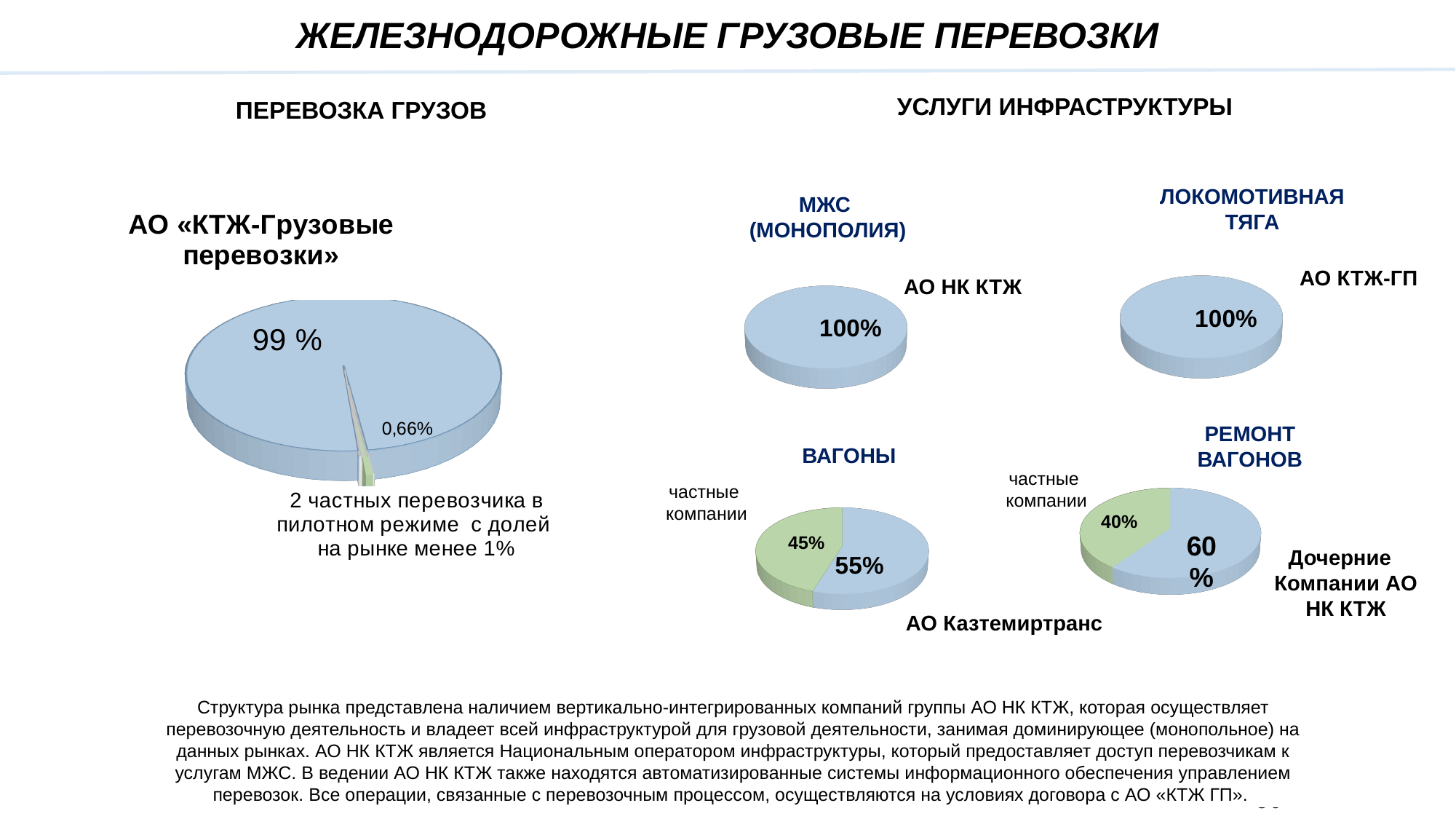
On the ВАГОНЫ pie chart, which slice is larger: АО Казтемиртранс or частные компании? АО Казтемиртранс On the ЛОКОМОТИВНАЯ ТЯГА pie chart, what share is labelled for АО КТЖ-ГП? 100% On the ПЕРЕВОЗКА ГРУЗОВ pie chart, what share is labelled for АО «КТЖ-Грузовые перевозки»? 99 % On the РЕМОНТ ВАГОНОВ pie chart, what share is labelled for Дочерние Компании АО НК КТЖ? 60% On the ВАГОНЫ pie chart, what share is labelled for частные компании? 45% On the ПЕРЕВОЗКА ГРУЗОВ pie chart, what value is labelled on the small green slice? 0,66% On the ВАГОНЫ pie chart, what share is labelled for АО Казтемиртранс? 55% How many pie charts are shown on the slide? 5 On the РЕМОНТ ВАГОНОВ pie chart, what is the difference between the Дочерние Компании АО НК КТЖ share and the частные компании share? 20% On the РЕМОНТ ВАГОНОВ pie chart, what share is labelled for частные компании? 40% What kind of chart is used under the heading ВАГОНЫ? Pie chart On the МЖС (МОНОПОЛИЯ) pie chart, what share is labelled for АО НК КТЖ? 100%